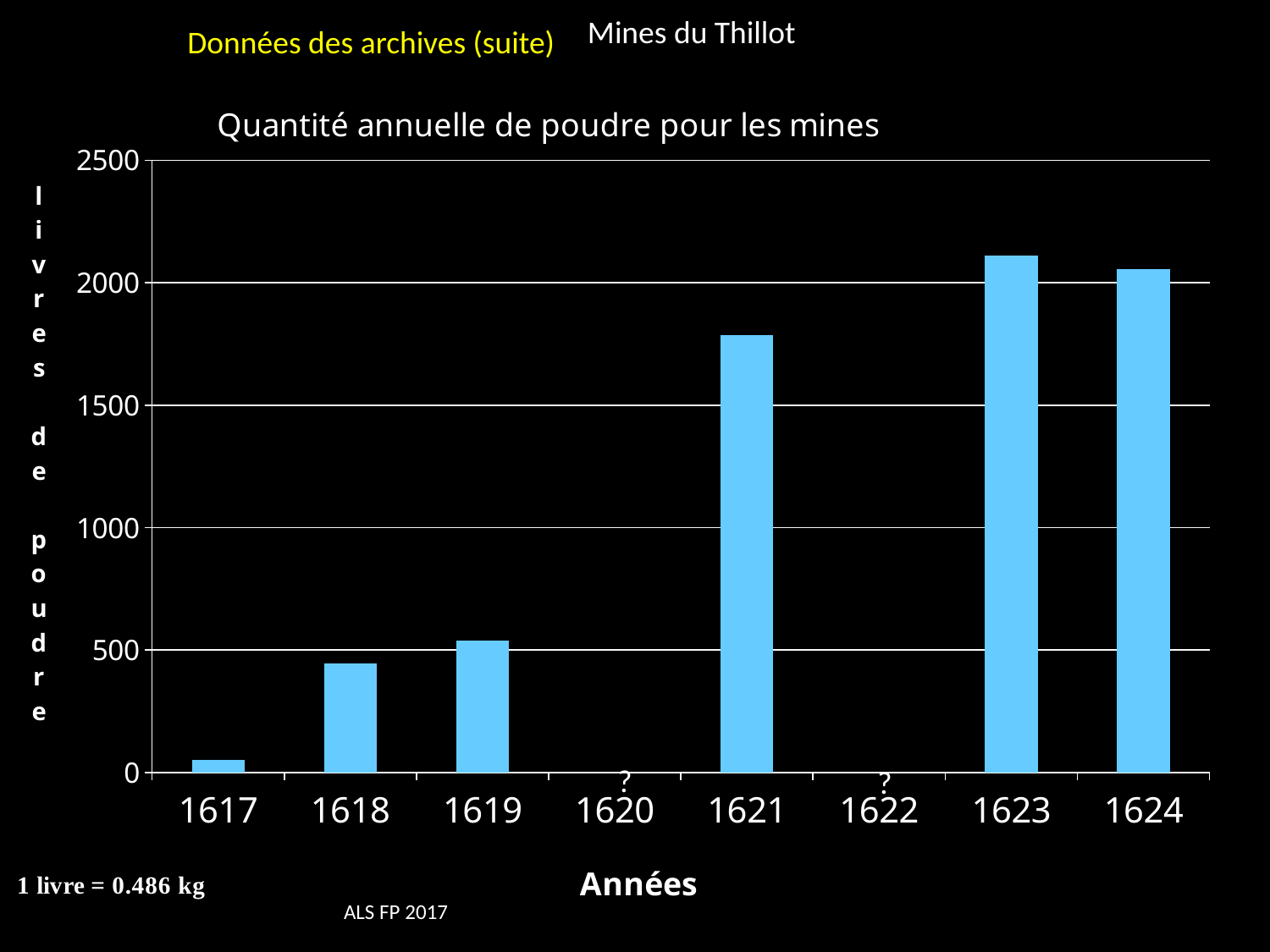
What kind of chart is shown on the slide? bar chart What is the title of the chart? Quantité annuelle de poudre pour les mines Is the value for 1621 greater or less than 1500? greater Is the value for 1619 greater or less than 500? greater Do the values generally rise or fall from 1617 to 1624? rise Which year has the larger value, 1619 or 1621? 1621 Is the value for 1617 greater or less than 500? less How many years are listed along the x axis of the chart? 8 Which year has the lowest quantity of powder in the chart? 1617 Which years on the x axis are marked with a question mark and have no bar? 1620 and 1622